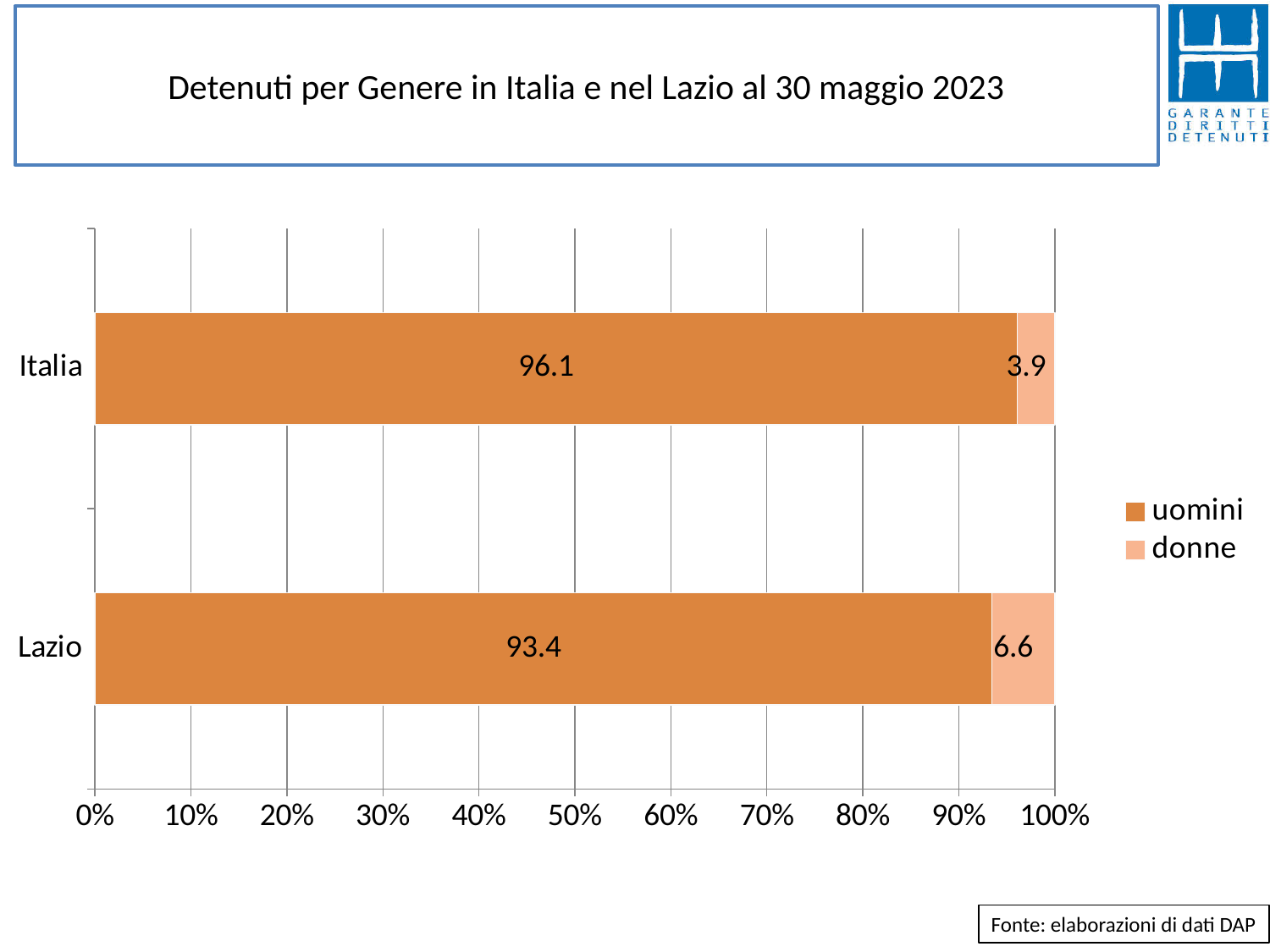
How many series does the legend list? 2 What is the difference between the donne values for Lazio and Italia? 2.7 What is the value for uomini in Italia? 96.1 Is the value for uomini in Lazio greater or less than 90%? greater Which region has the lower value for uomini? Lazio Which region has the higher value for donne, Italia or Lazio? Lazio What kind of chart is shown on the slide? Stacked bar chart What is the value for uomini in Lazio? 93.4 What is the value for donne in Italia? 3.9 What is the title of the chart? Detenuti per Genere in Italia e nel Lazio al 30 maggio 2023 What is the value for donne in Lazio? 6.6 What is the difference between the uomini values for Italia and Lazio? 2.7